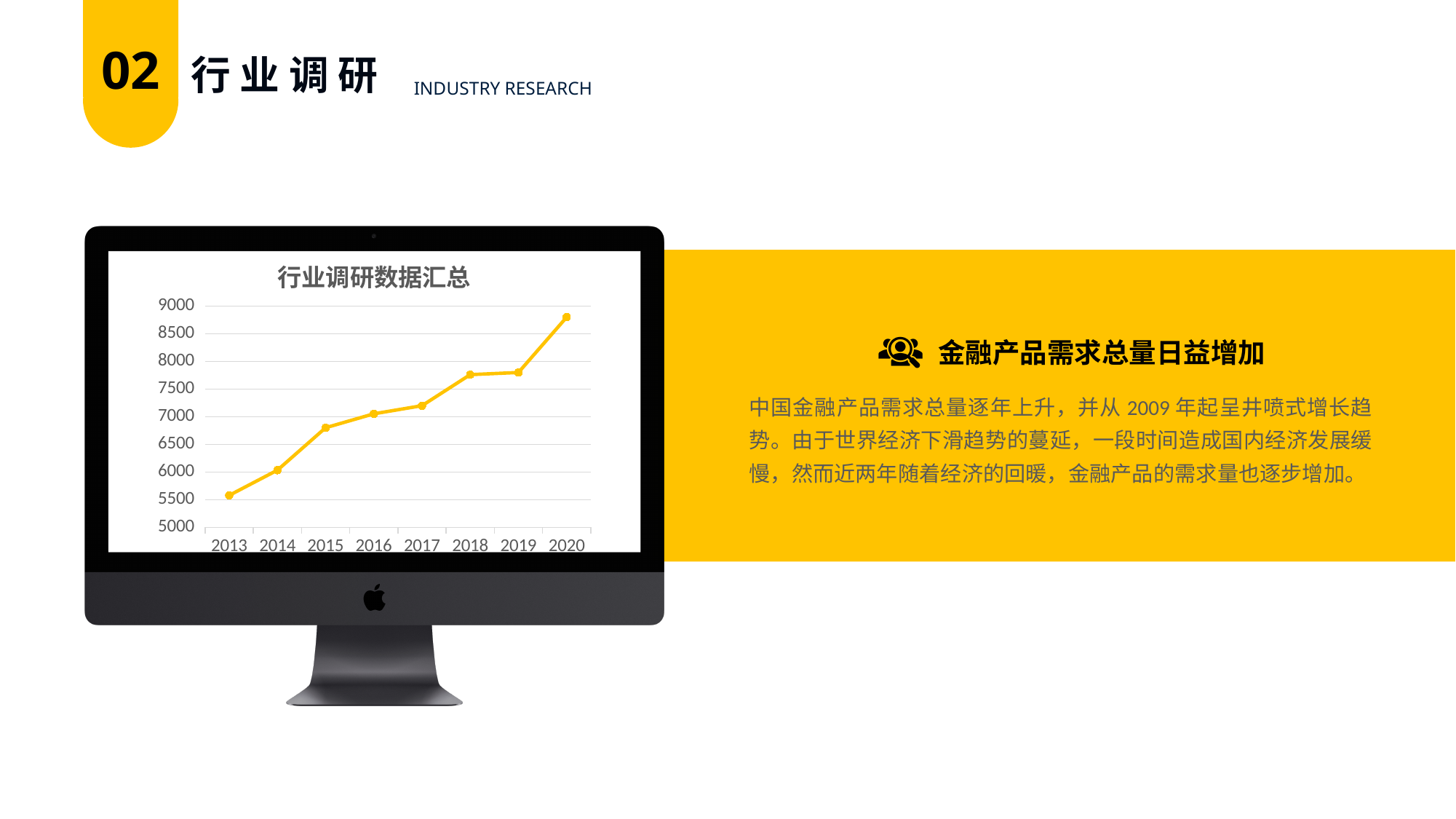
Is the value for 2013 greater or less than 6000? less What is the title of the chart? 行业调研数据汇总 Which year has the larger value, 2015 or 2014? 2015 Which year has the highest value in the chart? 2020 What kind of chart is shown on the monitor screen? line chart Is the value for 2020 greater or less than 8500? greater How many years are plotted on the x axis of the chart? 8 Is the value for 2019 greater or less than 8000? less Which year has the lowest value in the chart? 2013 Which year has the larger value, 2018 or 2016? 2018 Do the values generally rise or fall from 2013 to 2020? rise